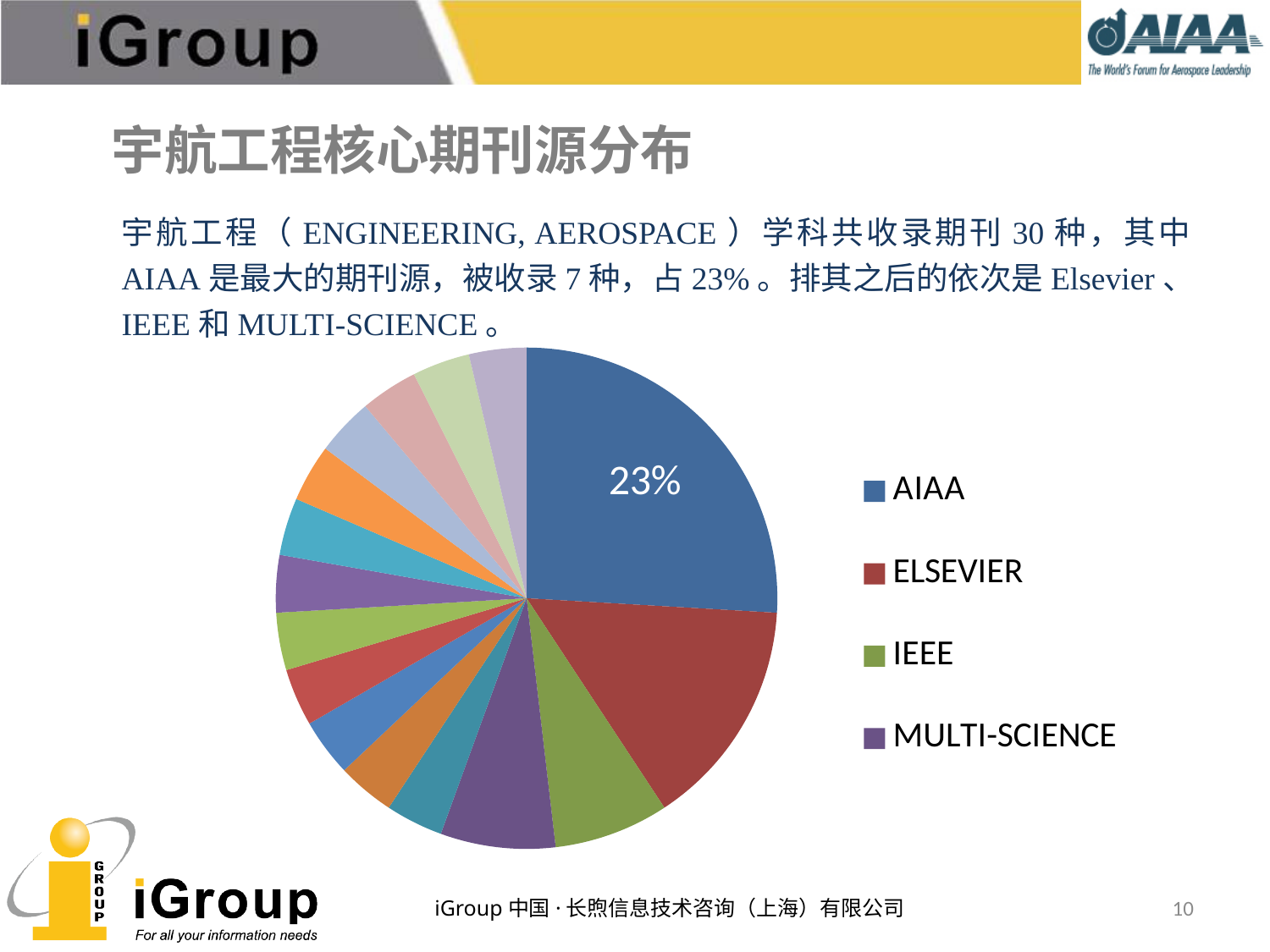
How many entries does the legend of the pie chart list? 4 Which slice is larger, AIAA or ELSEVIER? AIAA What is the value printed on the AIAA slice of the pie chart? 23% Which category has the largest slice in the pie chart? AIAA What share of the pie does the AIAA slice represent? 23% Which slice is larger, ELSEVIER or IEEE? ELSEVIER What colour is the AIAA slice in the pie chart? blue Is the AIAA slice greater or less than 20% of the pie? greater Which legend entries are listed for the pie chart? AIAA, ELSEVIER, IEEE, MULTI-SCIENCE What kind of chart is shown on the slide? pie chart Which slice of the pie chart has a percentage data label printed on it? AIAA